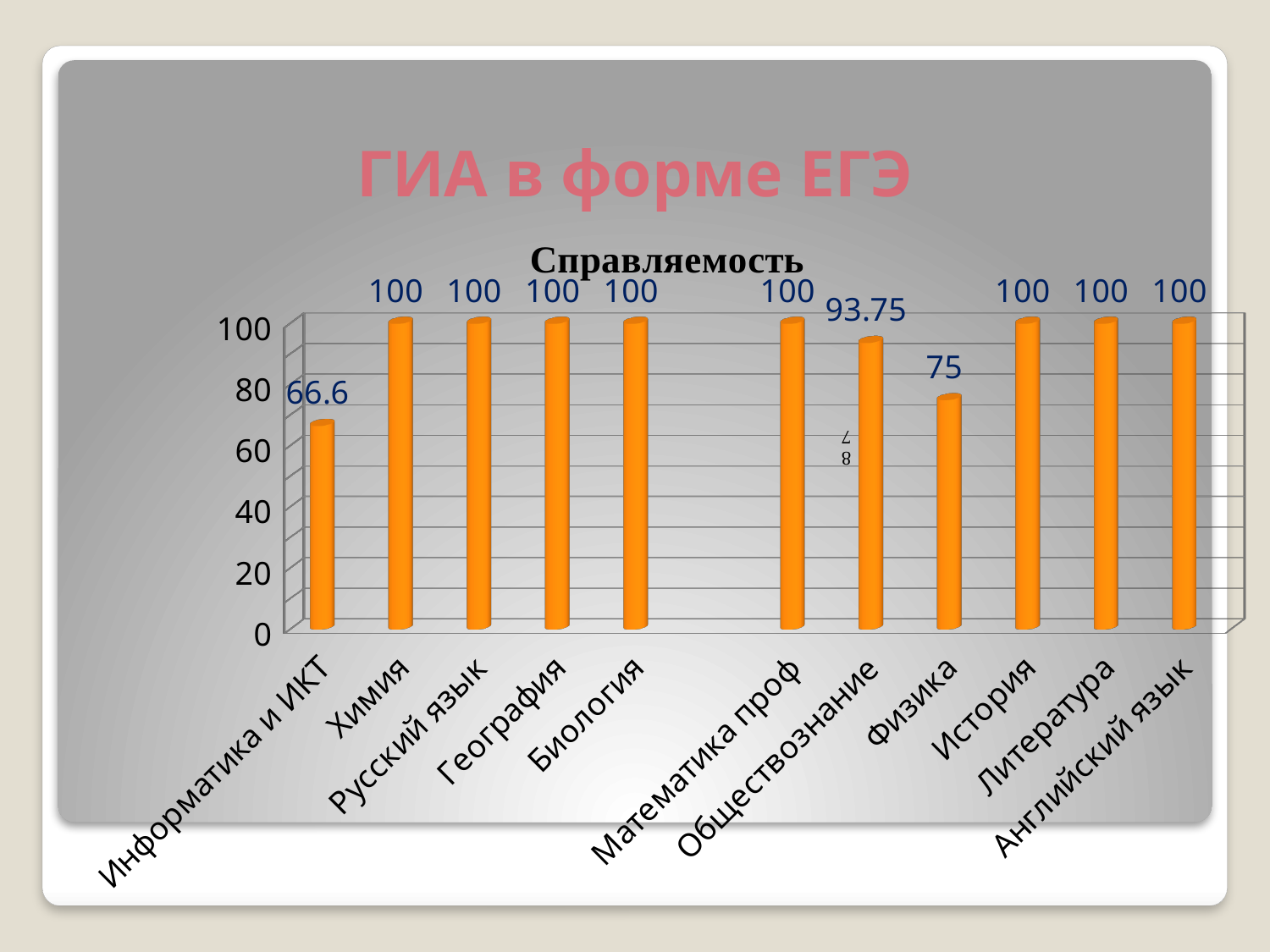
Is the value for Физика greater or less than 80? less Which category has the lowest value? Информатика и ИКТ What is the value for Физика? 75 How many bars are plotted in the chart? 11 What is the difference between the values for Обществознание and Физика? 18.75 What is the value for Химия? 100 What is the difference between the values for Химия and Информатика и ИКТ? 33.4 Which is larger, the value for Физика or the value for Обществознание? Обществознание What is the title of the chart? Справляемость What is the value for Информатика и ИКТ? 66.6 What type of chart is shown on the slide? bar chart What is the value for Обществознание? 93.75